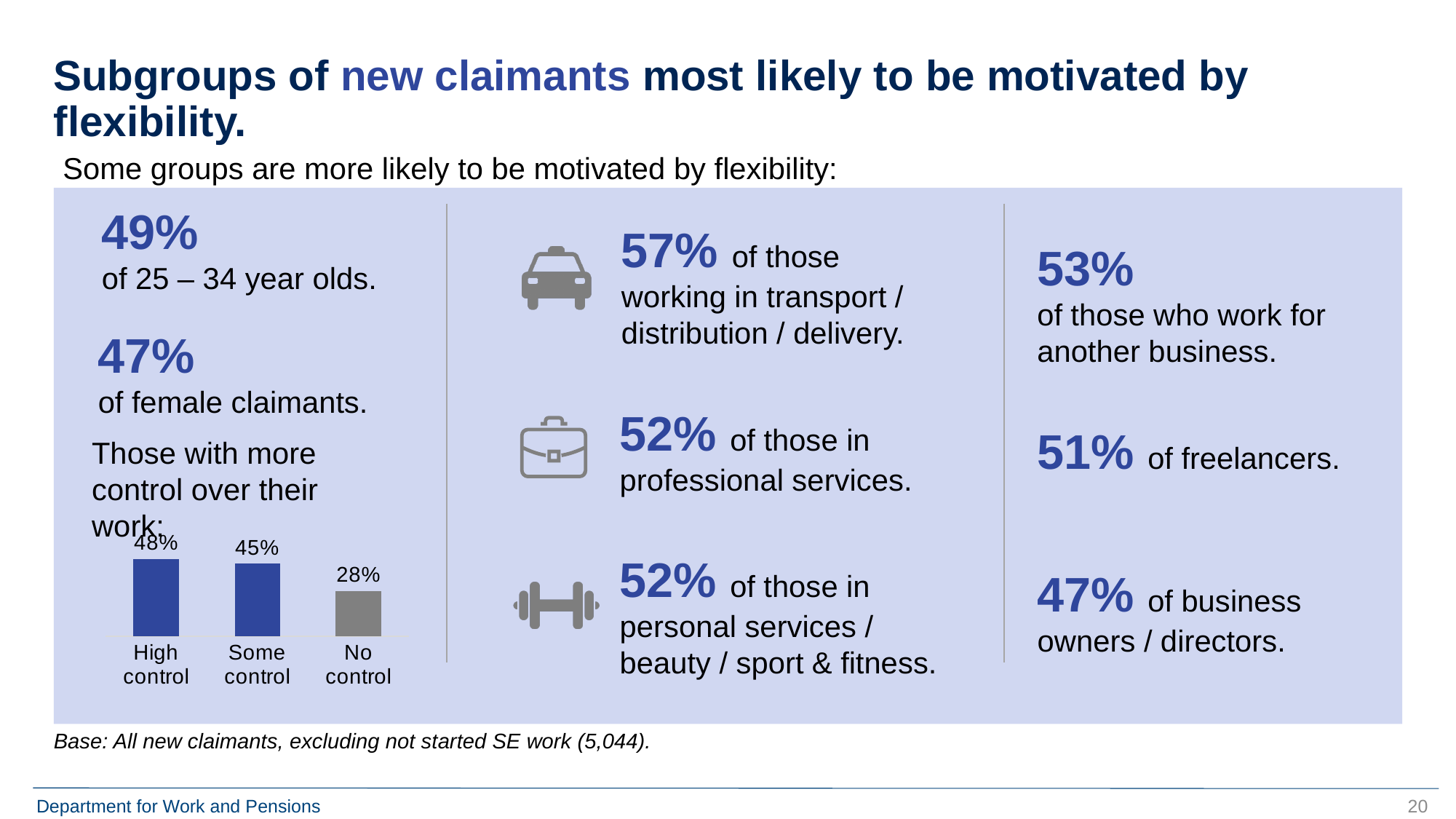
Do the values in the bar chart rise or fall from High control to No control? Fall What kind of chart is shown on the slide? Bar chart What is the value for Some control in the bar chart? 45% What is the difference between the High control and No control values in the bar chart? 20% What is the value for High control in the bar chart? 48% Which bar in the chart is coloured grey rather than blue? No control What is the value for No control in the bar chart? 28% Which category in the bar chart has the highest value? High control How many categories are shown in the bar chart? 3 Which is larger in the bar chart, Some control or No control? Some control What is the difference between the Some control and No control values in the bar chart? 17% Which category in the bar chart has the lowest value? No control